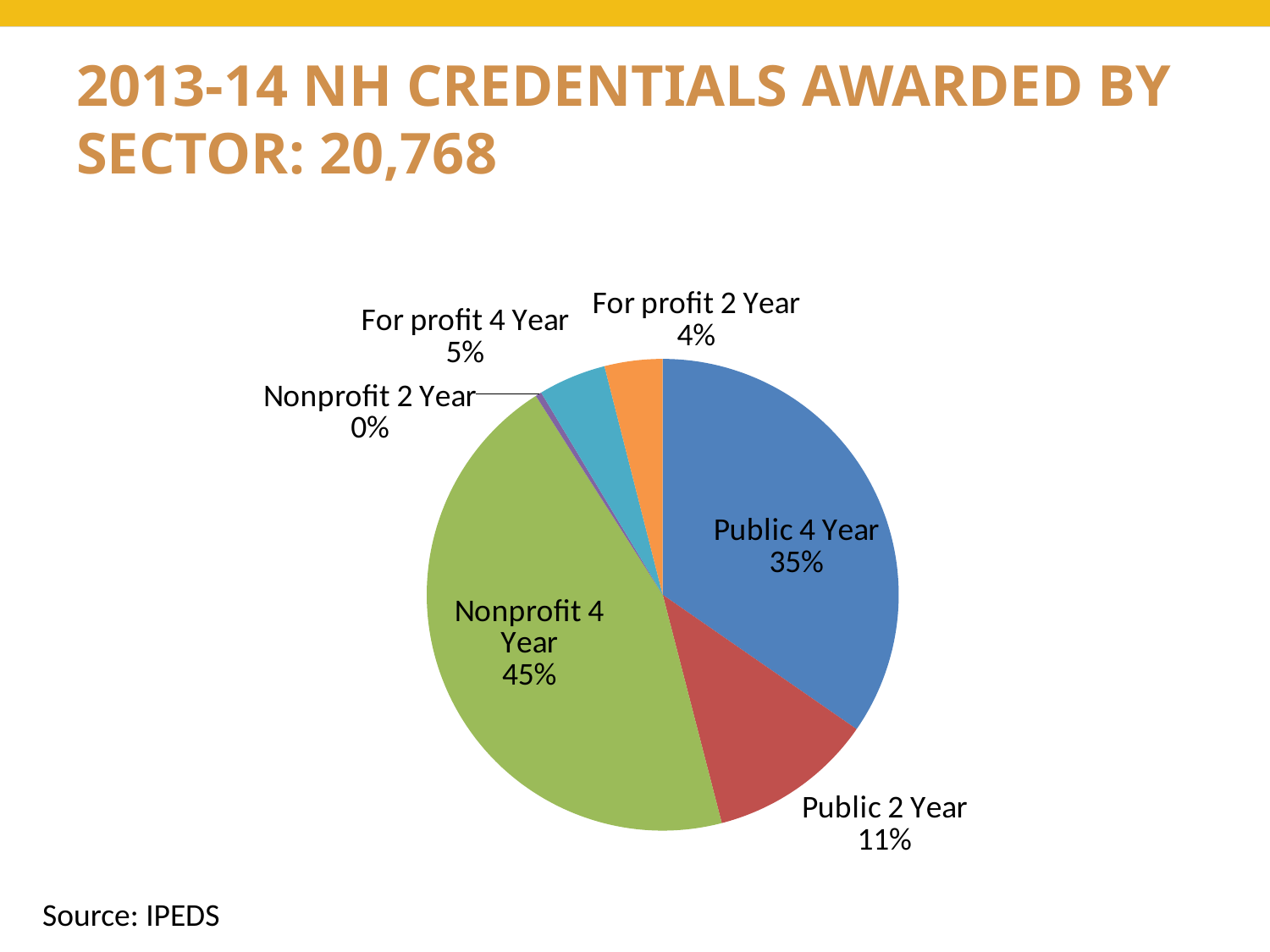
Which sector has a larger share, Public 2 Year or For profit 4 Year? Public 2 Year What share of credentials was awarded by the For profit 4 Year sector? 5% What share of credentials was awarded by the Nonprofit 2 Year sector? 0% Which sector has the largest share of credentials awarded? Nonprofit 4 Year How many sectors are shown in the pie chart? 6 What kind of chart is shown on the slide? Pie chart What share of credentials was awarded by the Public 2 Year sector? 11% Which sector has the smallest share of credentials awarded? Nonprofit 2 Year What is the difference in percentage points between the Nonprofit 4 Year and Public 4 Year shares? 10 percentage points